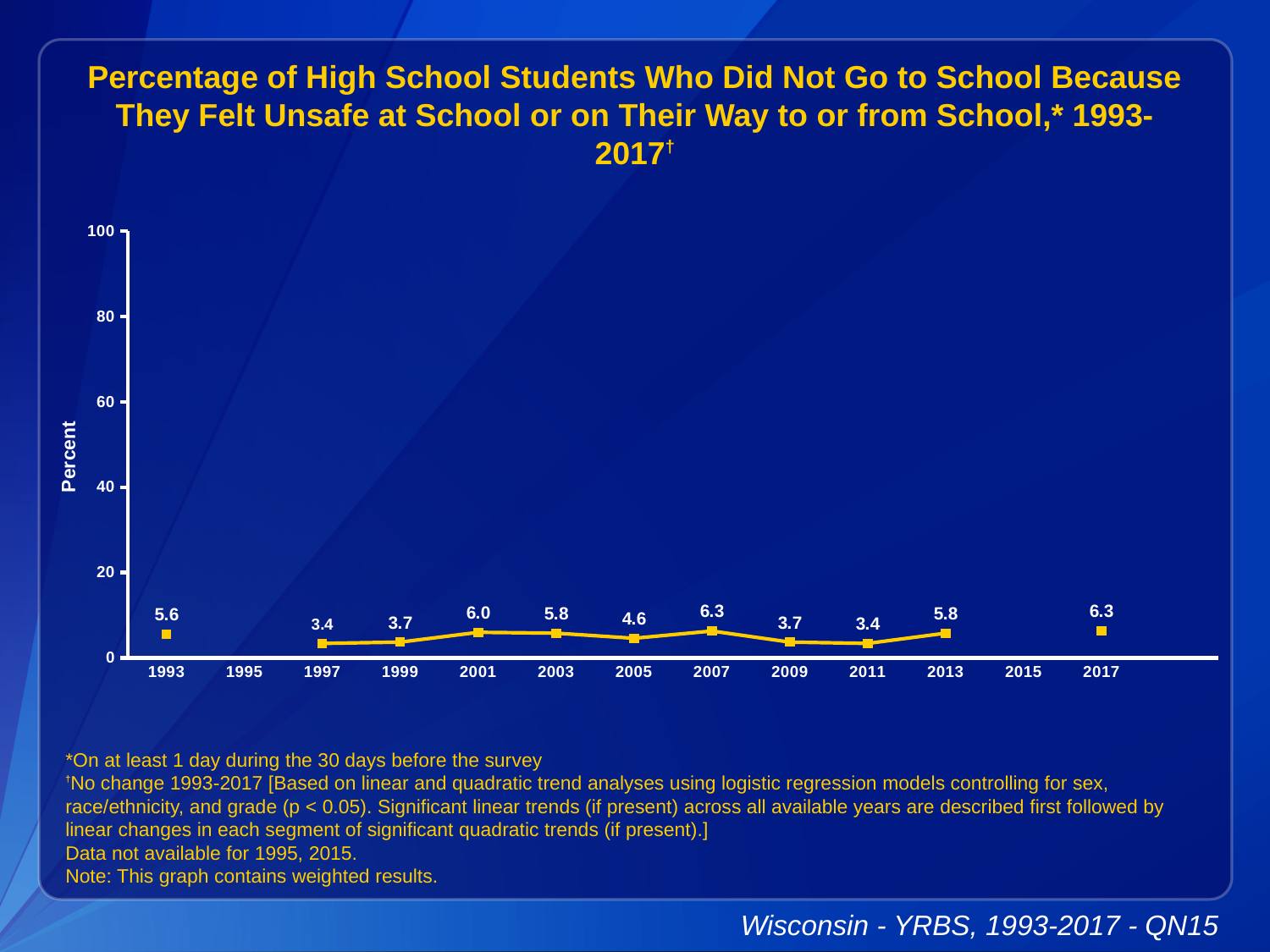
What value is plotted for 2011? 3.4 What value is plotted for 2007? 6.3 What was the percentage of students who did not go to school because they felt unsafe in 1993? 5.6 What type of chart is shown on the slide? line chart What is the highest value plotted on the chart? 6.3 How many years have a data point plotted on the chart? 11 Is the value for 2003 greater or less than 20? less Which year has the larger value, 2005 or 2013? 2013 What is the label on the y axis? Percent What is the lowest value plotted on the chart? 3.4 What is the difference between the values for 2001 and 1997? 2.6 What value is plotted for 2017? 6.3